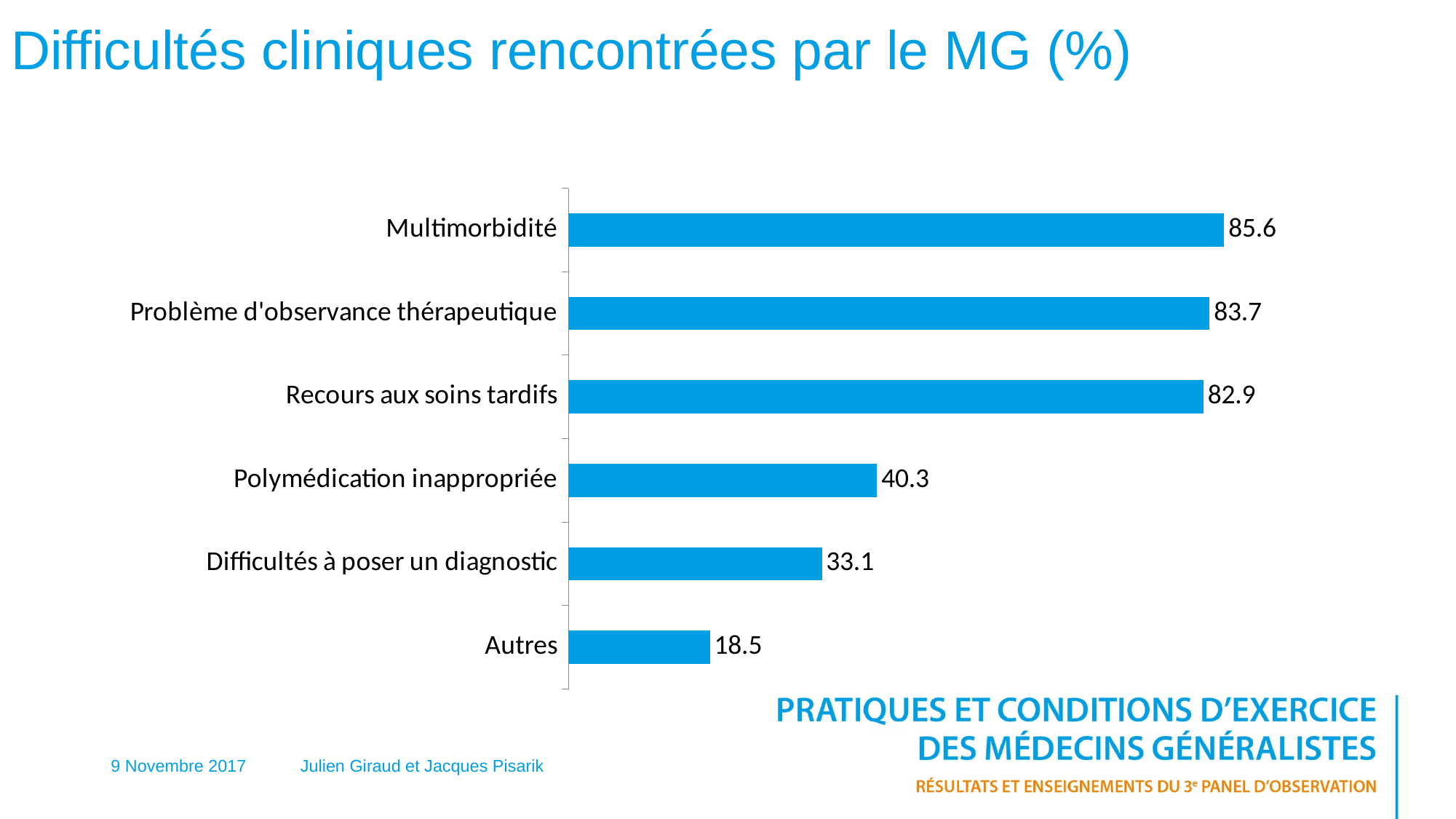
Which is larger: the value for Recours aux soins tardifs or the value for Polymédication inappropriée? Recours aux soins tardifs Which category has the highest value? Multimorbidité What is the difference between the values for Multimorbidité and Autres? 67.1 What is the title of the slide? Difficultés cliniques rencontrées par le MG (%) What kind of chart is shown on the slide? Bar chart What is the value for Autres? 18.5 How many categories are shown in the chart? 6 Which category has the lowest value? Autres What is the value for Multimorbidité? 85.6 What is the value for Polymédication inappropriée? 40.3 What is the value for Difficultés à poser un diagnostic? 33.1 What is the difference between the values for Polymédication inappropriée and Difficultés à poser un diagnostic? 7.2